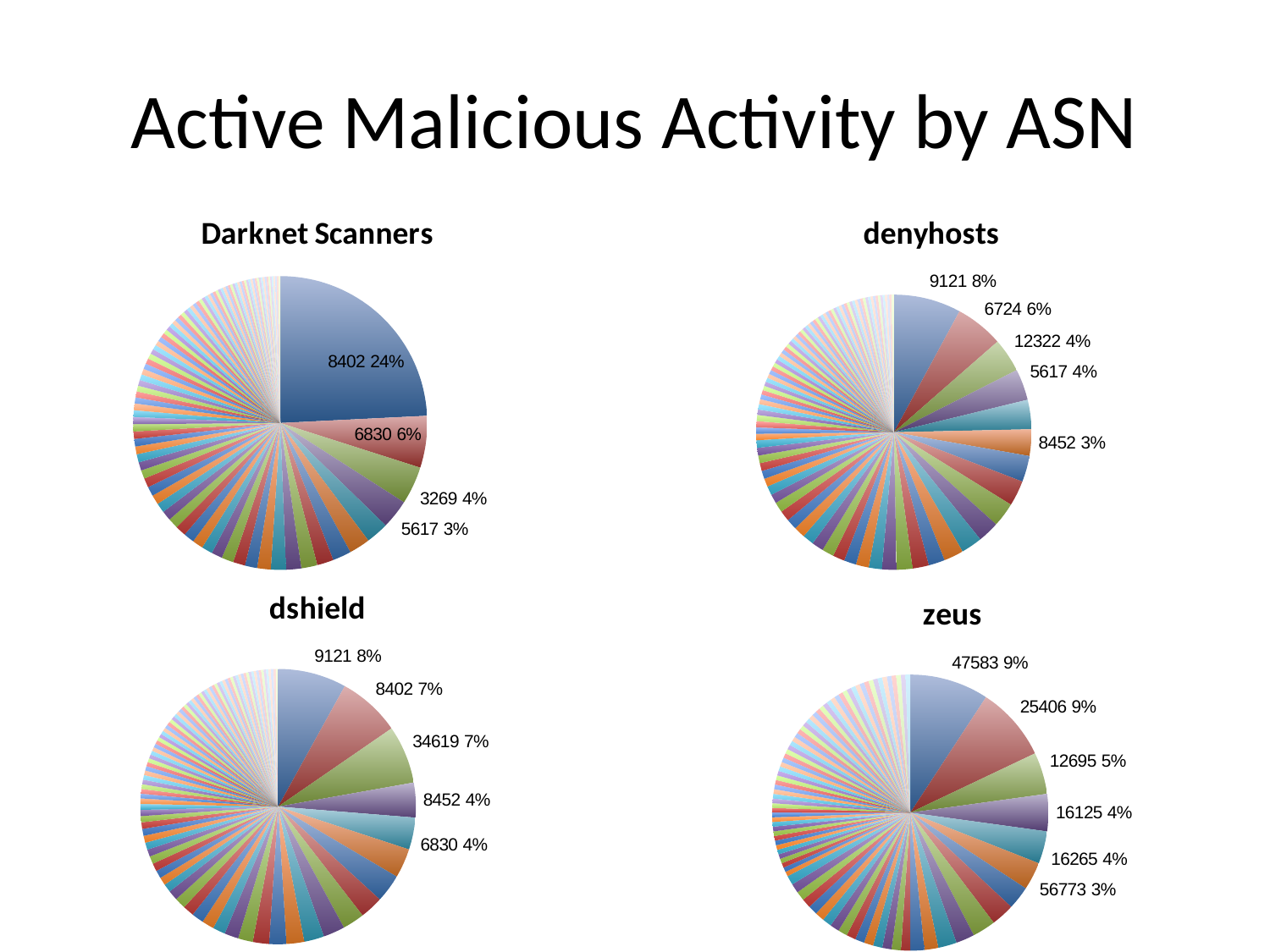
In the denyhosts chart, what share of the pie does ASN 6724 have? 6% In the Darknet Scanners chart, what share of the pie does ASN 8402 have? 24% In the zeus chart, what share of the pie does ASN 12695 have? 5% What is the title of the chart in the bottom-right of the slide? zeus In the dshield chart, which is larger, the slice for ASN 9121 or the slice for ASN 8452? 9121 In the zeus chart, what is the difference in percentage points between the share for ASN 47583 and the share for ASN 56773? 6 In the denyhosts chart, which labelled ASN has the largest slice? 9121 How many charts are shown on the slide? 4 In the Darknet Scanners chart, what is the difference in percentage points between the share for ASN 8402 and the share for ASN 6830? 18 In the Darknet Scanners chart, which labelled ASN has the largest slice? 8402 What kind of chart is the dshield chart? Pie chart